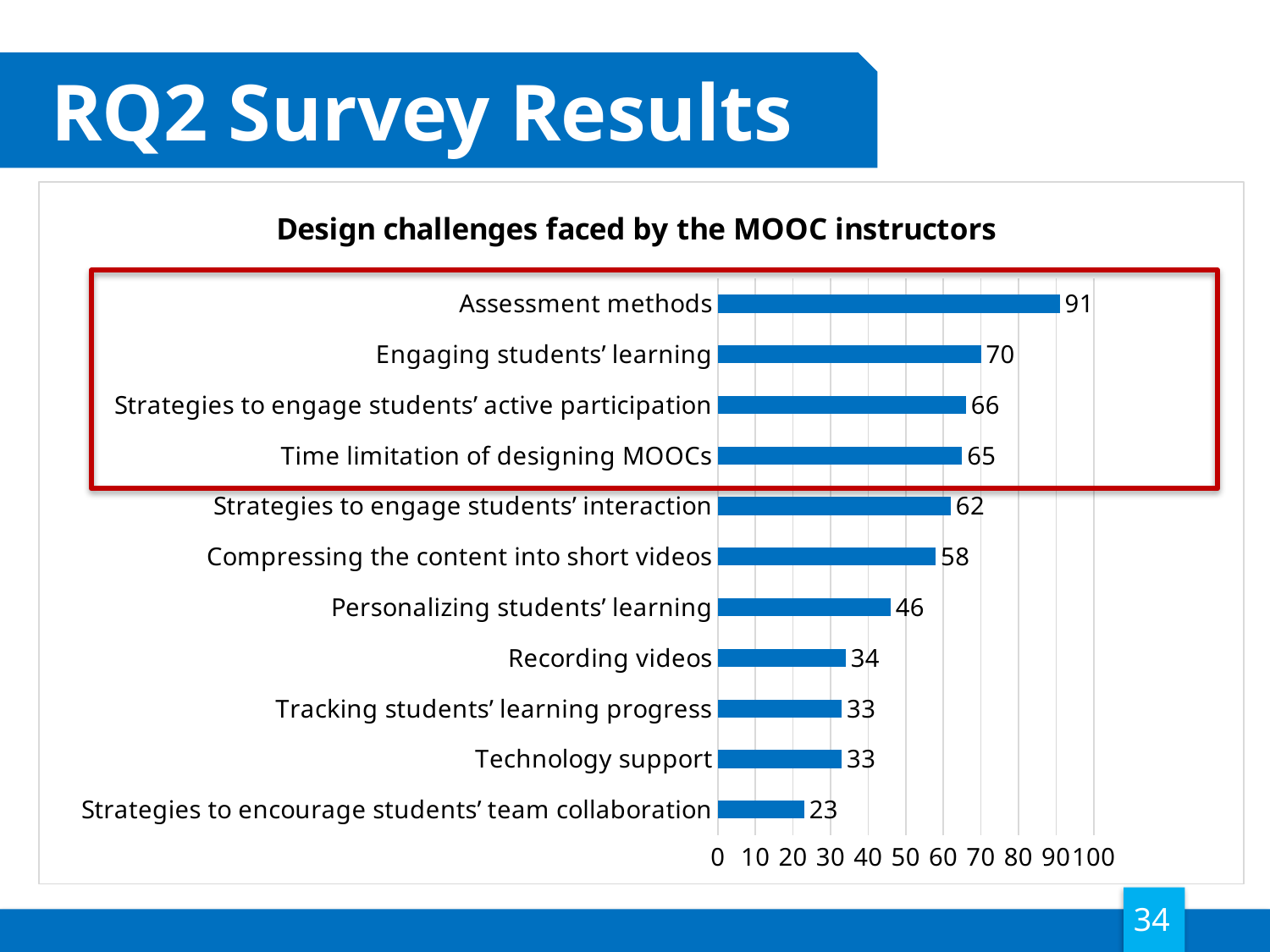
Is the value for Compressing the content into short videos greater or less than 50? greater How many categories are enclosed by the red box on the chart? 4 What is the difference between the values for Assessment methods and Engaging students' learning? 21 What is the title of the chart? Design challenges faced by the MOOC instructors What is the value for Personalizing students' learning? 46 How many categories are shown in the chart? 11 Which category has the lowest value? Strategies to encourage students' team collaboration Which category has the highest value? Assessment methods What kind of chart is shown on the slide? bar chart Which is larger, the value for Recording videos or the value for Personalizing students' learning? Personalizing students' learning What is the value for Assessment methods? 91 What is the value for Time limitation of designing MOOCs? 65